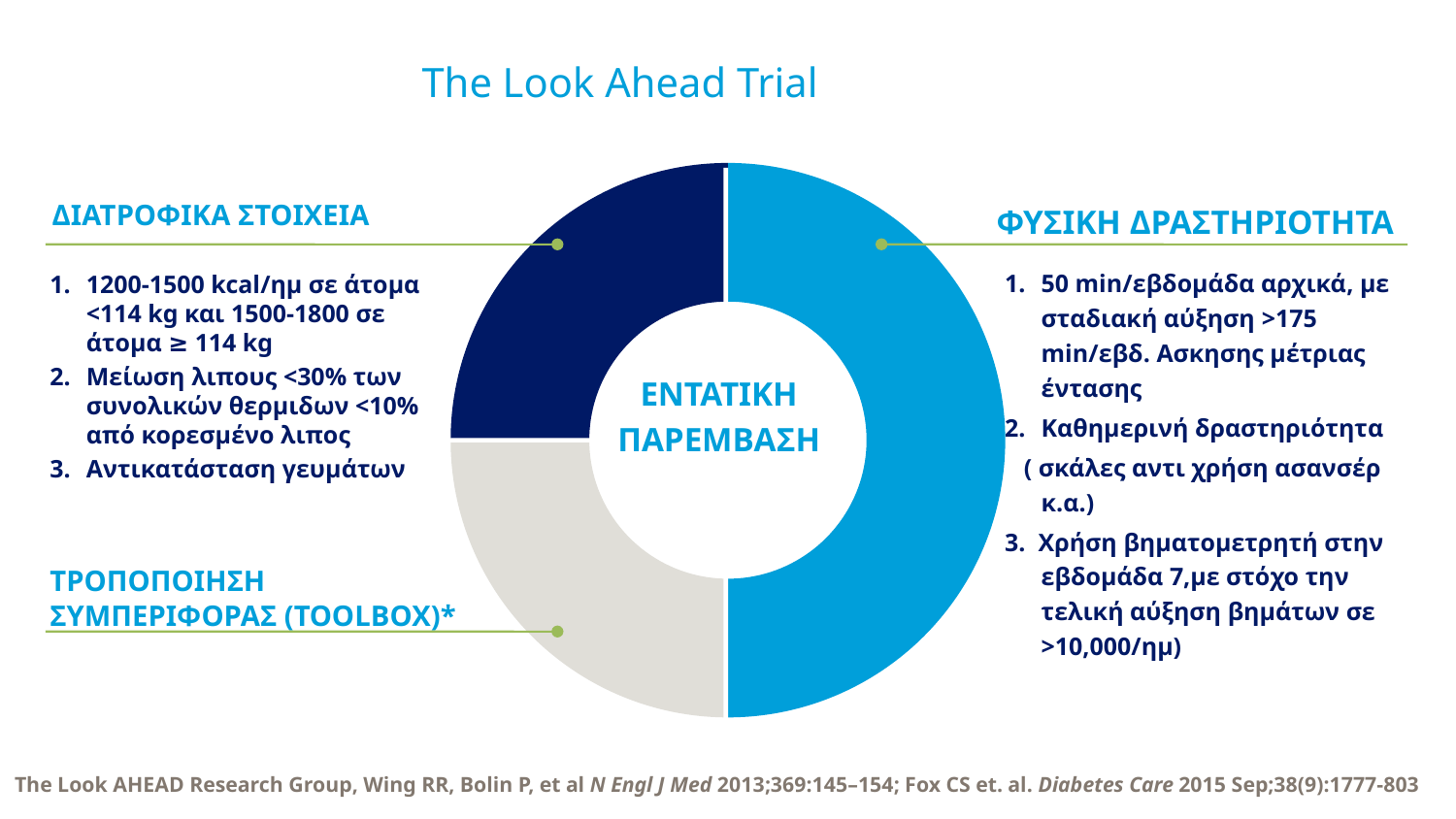
Which segment is larger: ΦΥΣΙΚΗ ΔΡΑΣΤΗΡΙΟΤΗΤΑ or ΤΡΟΠΟΠΟΙΗΣΗ ΣΥΜΠΕΡΙΦΟΡΑΣ (TOOLBOX)*? ΦΥΣΙΚΗ ΔΡΑΣΤΗΡΙΟΤΗΤΑ What text is written in the centre of the donut chart? ΕΝΤΑΤΙΚΗ ΠΑΡΕΜΒΑΣΗ Which segment of the donut chart is the largest? ΦΥΣΙΚΗ ΔΡΑΣΤΗΡΙΟΤΗΤΑ What colour is the segment labelled ΔΙΑΤΡΟΦΙΚΑ ΣΤΟΙΧΕΙΑ? Dark navy blue What kind of chart is shown on the slide? Pie chart (donut) How many segments does the donut chart have? 3 Which segment is larger: ΦΥΣΙΚΗ ΔΡΑΣΤΗΡΙΟΤΗΤΑ or ΔΙΑΤΡΟΦΙΚΑ ΣΤΟΙΧΕΙΑ? ΦΥΣΙΚΗ ΔΡΑΣΤΗΡΙΟΤΗΤΑ